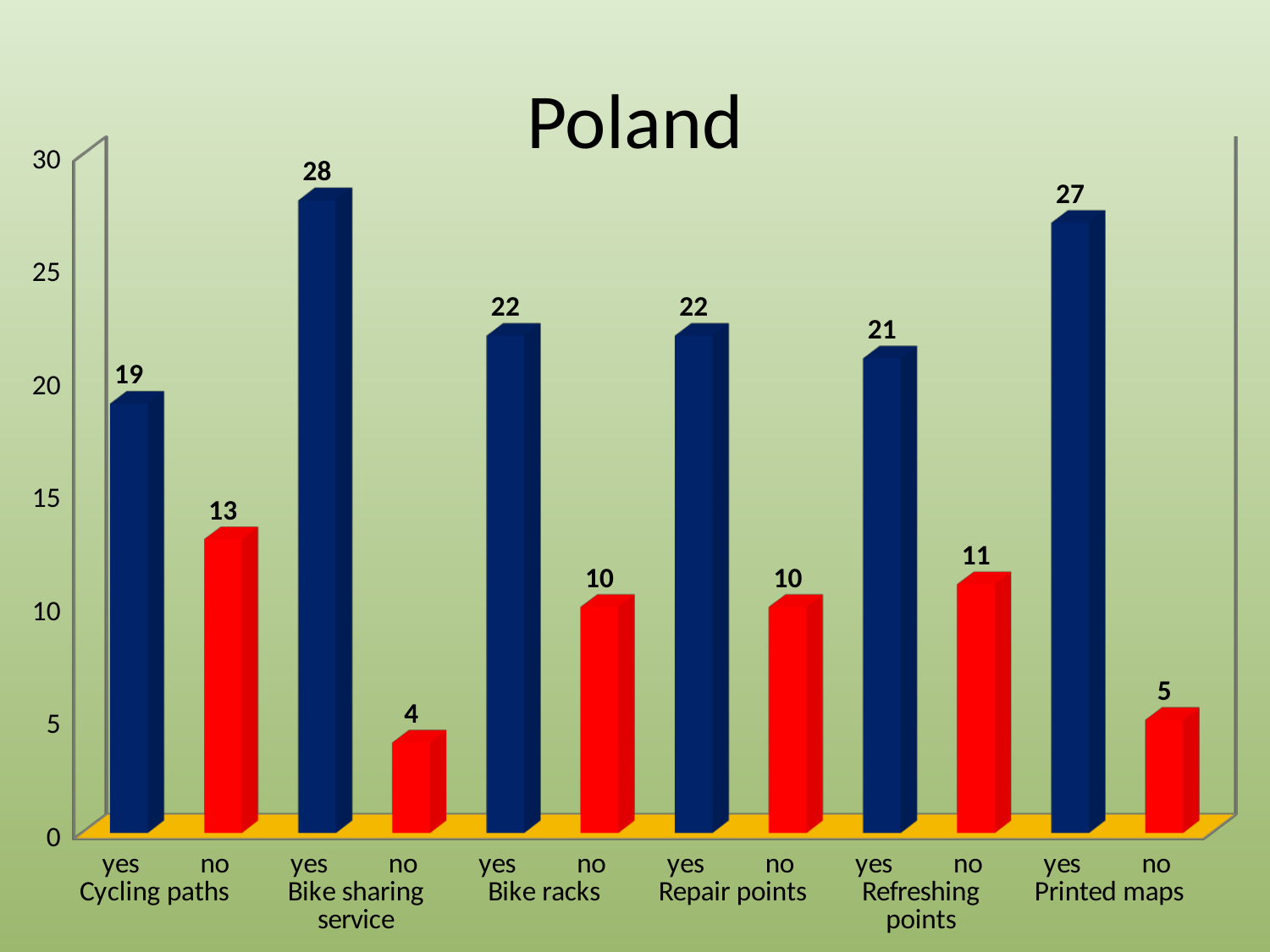
Is the 'yes' value for Bike racks greater or less than 20? greater What is the value of the 'yes' bar for Printed maps? 27 What is the total of the 'yes' and 'no' values for Repair points? 32 What is the value of the 'yes' bar for Cycling paths? 19 How many categories are shown on the x axis? 6 What is the title of the chart? Poland What kind of chart is shown on the slide? bar chart What is the difference between the 'yes' and 'no' values for Refreshing points? 10 What is the value of the 'no' bar for Bike sharing service? 4 Which category has the lowest 'no' value? Bike sharing service Which category has the highest 'yes' value? Bike sharing service Which is larger: the 'no' value for Cycling paths or the 'no' value for Printed maps? Cycling paths